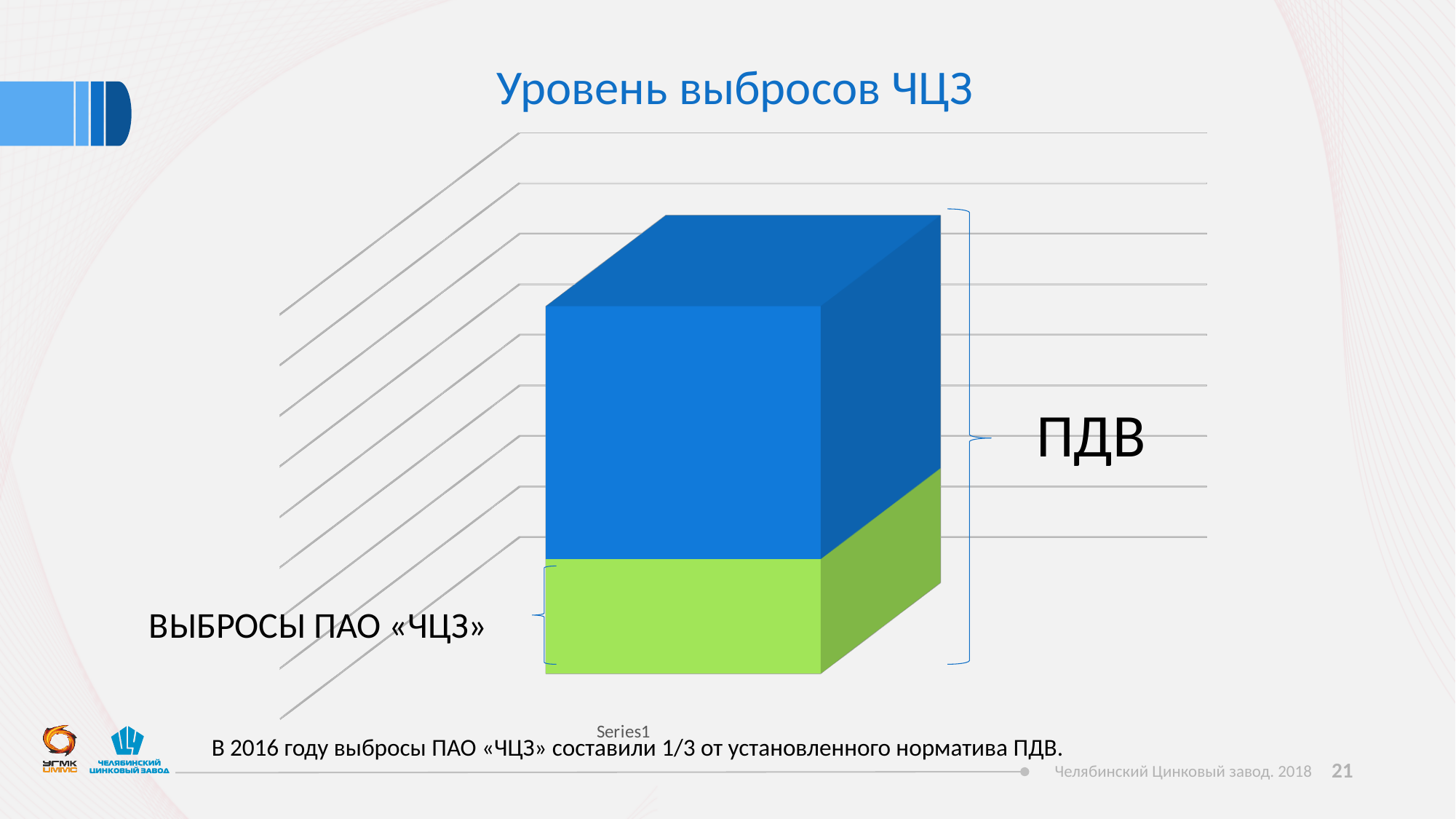
Which segment of the bar is larger: the blue segment or the green segment labelled ВЫБРОСЫ ПАО «ЧЦЗ»? The blue segment What is the title of the chart on the slide? Уровень выбросов ЧЦЗ How many bars does the chart contain? 1 How many segments make up the stacked bar in the chart? 2 According to the slide, what fraction of the ПДВ norm did the emissions of ПАО «ЧЦЗ» make up in 2016? 1/3 Is the green segment (ВЫБРОСЫ ПАО «ЧЦЗ») smaller or larger than half of the full bar height (ПДВ)? Smaller Which label is attached to the bracket spanning the full height of the bar? ПДВ What kind of chart is shown on the slide? Stacked bar chart Which label is attached to the green segment at the bottom of the bar? ВЫБРОСЫ ПАО «ЧЦЗ» What is the category label shown on the x axis of the chart? Series1